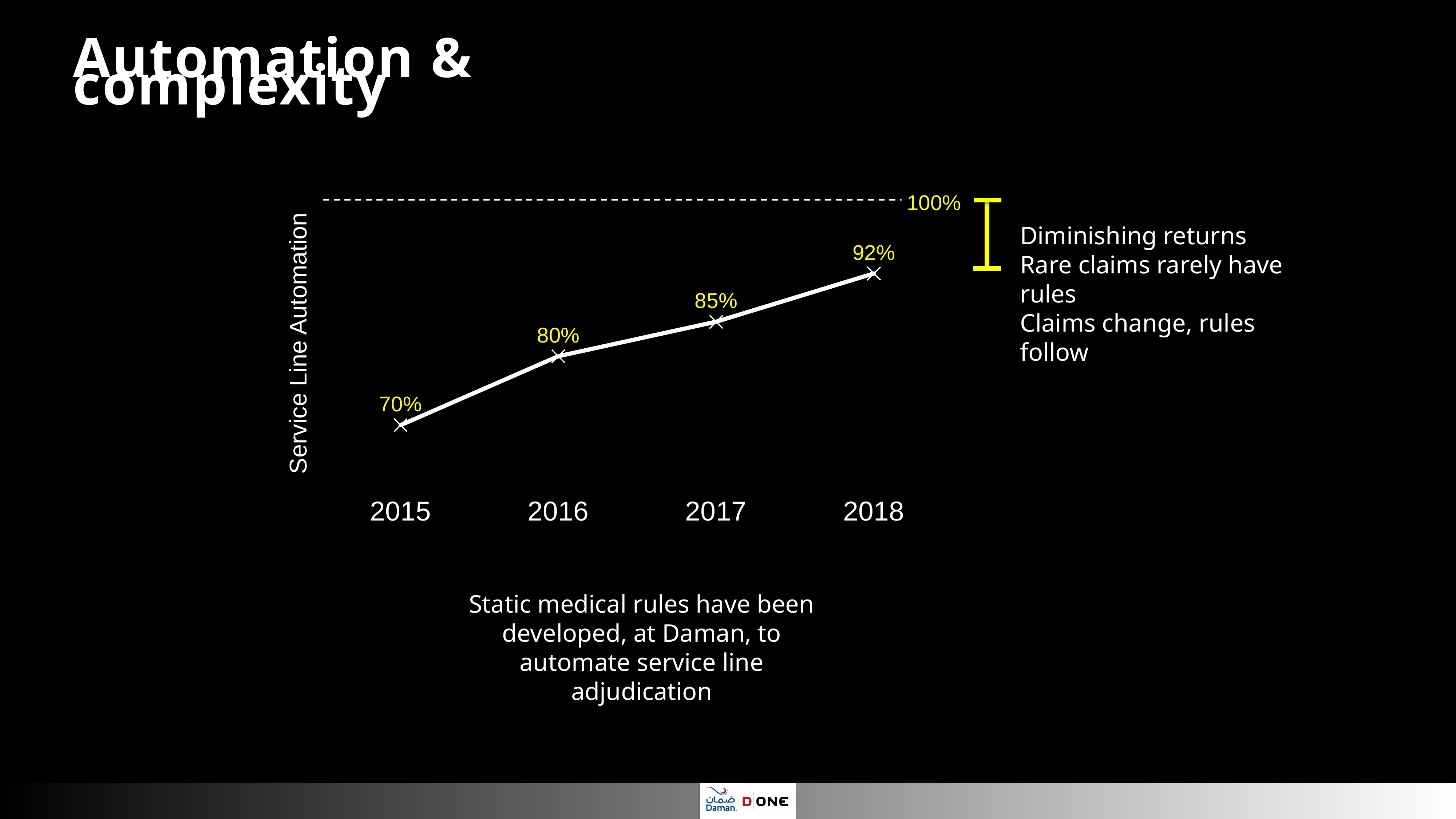
Do the Service Line Automation values rise or fall from 2015 to 2018? Rise What is the Service Line Automation value for 2018? 92% What is the difference between the Service Line Automation values for 2018 and 2015? 22% Which year has the lowest Service Line Automation value? 2015 Which year has the highest Service Line Automation value? 2018 How many years are plotted on the chart? 4 What is the difference between the Service Line Automation values for 2016 and 2015? 10% Which year has a larger Service Line Automation value, 2016 or 2017? 2017 What is the Service Line Automation value for 2016? 80% What is the Service Line Automation value for 2015? 70% What kind of chart is shown on the slide? Line chart What is the Service Line Automation value for 2017? 85%